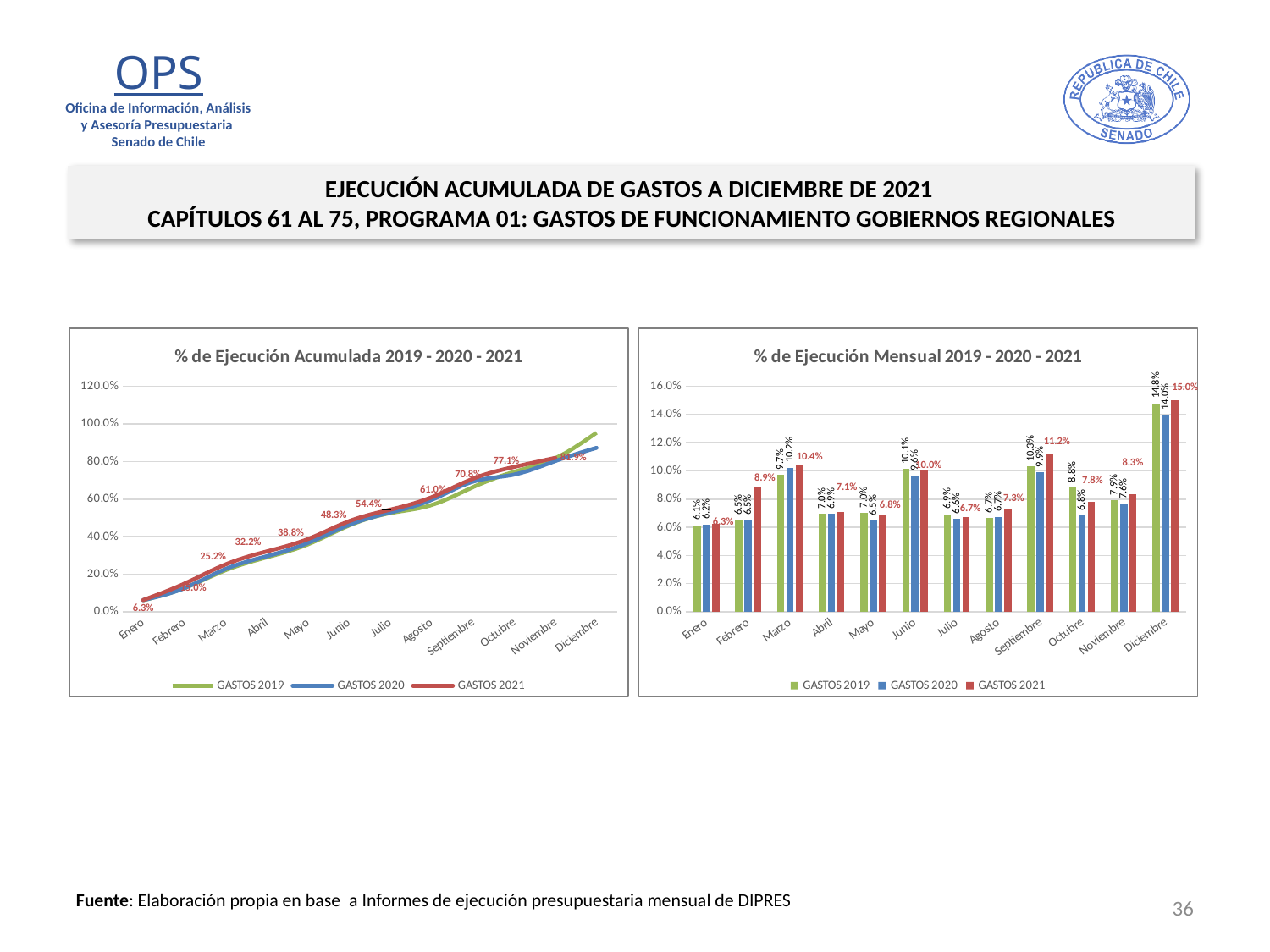
In the '% de Ejecución Acumulada 2019 - 2020 - 2021' chart, what is the difference between the GASTOS 2021 values for Octubre and Septiembre? 6.3 percentage points In the '% de Ejecución Mensual 2019 - 2020 - 2021' chart, what is the value for GASTOS 2021 in Septiembre? 11.2% In the '% de Ejecución Mensual 2019 - 2020 - 2021' chart, what is the difference between GASTOS 2021 and GASTOS 2020 in Diciembre? 1.0 percentage points In the '% de Ejecución Mensual 2019 - 2020 - 2021' chart, how many series does the legend list? 3 In the '% de Ejecución Mensual 2019 - 2020 - 2021' chart, which month has the highest value for GASTOS 2021? Diciembre In the '% de Ejecución Mensual 2019 - 2020 - 2021' chart, which is larger in Febrero: GASTOS 2019 or GASTOS 2021? GASTOS 2021 In the '% de Ejecución Mensual 2019 - 2020 - 2021' chart, how many months are shown on the x axis? 12 In the '% de Ejecución Acumulada 2019 - 2020 - 2021' chart, do the GASTOS 2021 values rise or fall from Enero to Octubre? Rise What type of chart is the '% de Ejecución Acumulada 2019 - 2020 - 2021' chart on the left? Line chart In the '% de Ejecución Mensual 2019 - 2020 - 2021' chart, what is the value for GASTOS 2021 in Diciembre? 15.0% What type of chart is the '% de Ejecución Mensual 2019 - 2020 - 2021' chart on the right? Bar chart In the '% de Ejecución Acumulada 2019 - 2020 - 2021' chart, what is the value for GASTOS 2021 in Julio? 54.4%